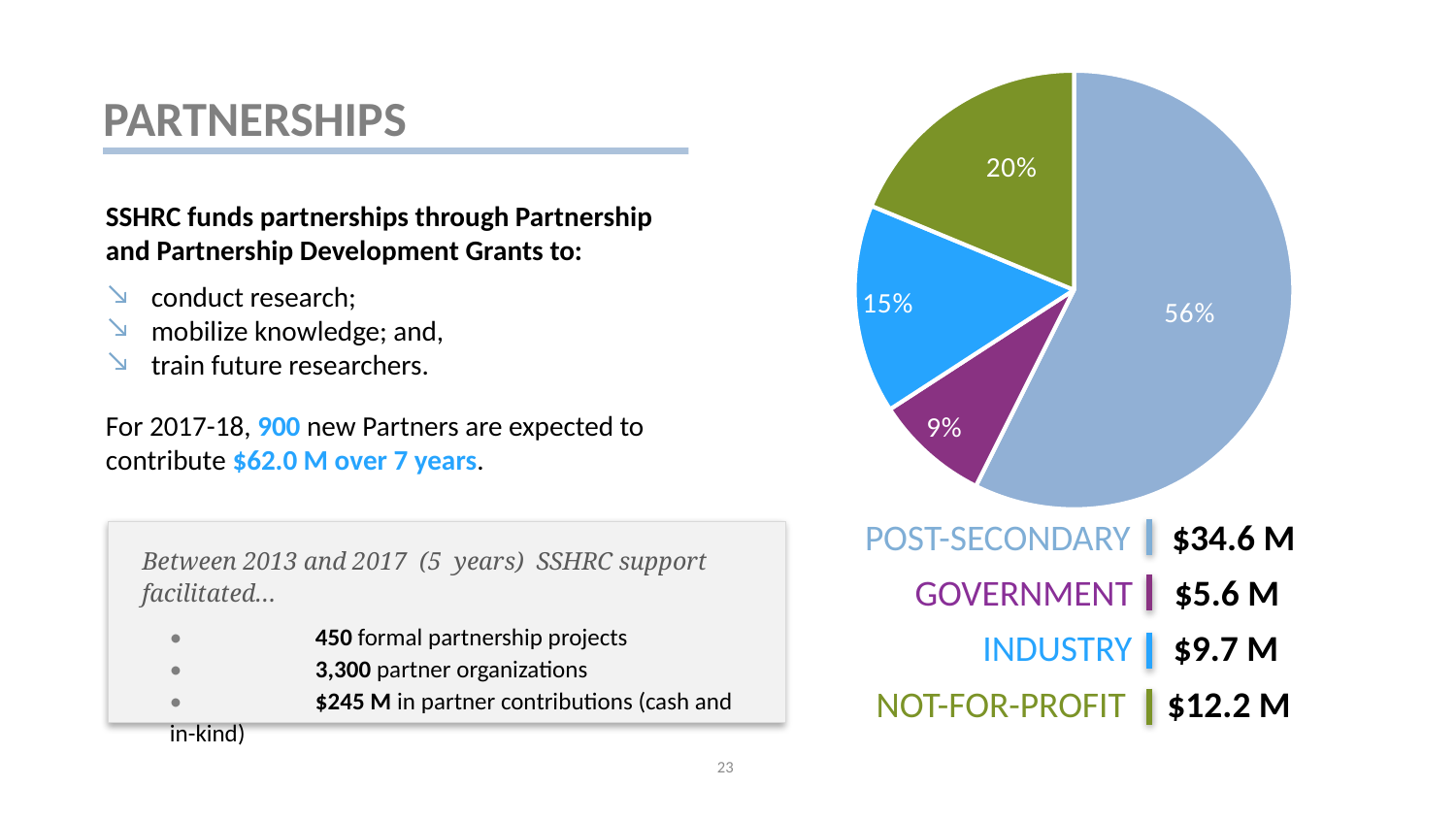
What is the difference in percentage points between the Post-Secondary slice and the Not-for-Profit slice? 36 What dollar amount is listed for Not-for-Profit? $12.2 M What percentage of the pie does the Not-for-Profit slice represent? 20% Which is larger, the Industry slice or the Not-for-Profit slice? Not-for-Profit What percentage of the pie does the Industry slice represent? 15% What dollar amount is listed for Post-Secondary? $34.6 M Which category has the smallest slice of the pie? Government What percentage of the pie does the Post-Secondary slice represent? 56% How many slices does the pie chart have? 4 Which category has the largest slice of the pie? Post-Secondary What kind of chart is shown on the slide? pie chart